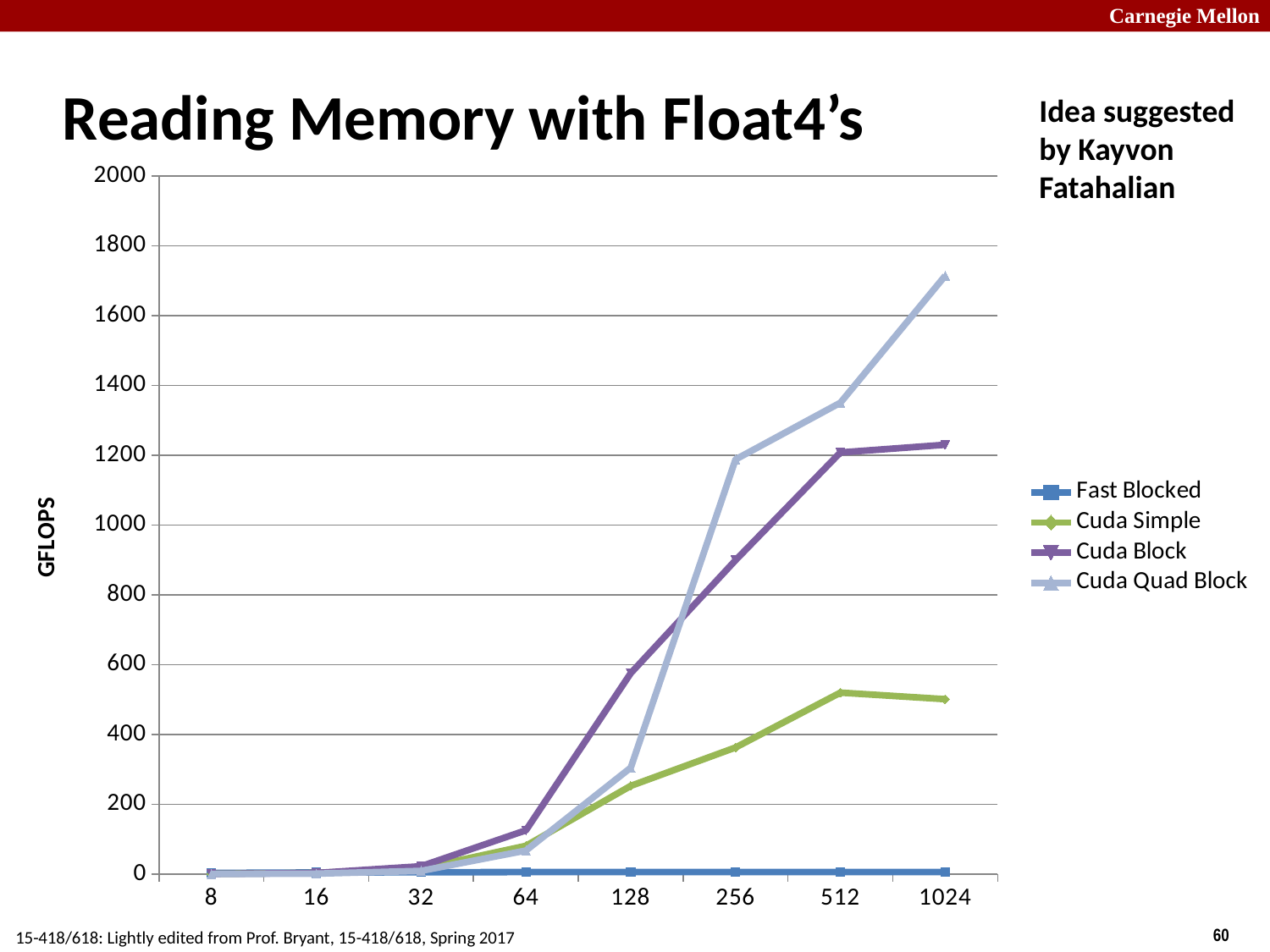
How many series does the legend list? 4 At 256, which is larger: Cuda Quad Block or Cuda Block? Cuda Quad Block Is the value for Cuda Simple at 1024 greater or less than 600? less What is the label on the y axis? GFLOPS Does the Cuda Quad Block series rise or fall from 8 to 1024? rise Is the value for Cuda Block at 512 greater or less than 1000? greater How many points are on the x axis? 8 What kind of chart is shown on the slide? line chart Which series has the highest value at 128? Cuda Block Is the value for Cuda Quad Block at 1024 greater or less than 1600? greater Which series has the highest value at 1024? Cuda Quad Block Which series has the lowest value at 1024? Fast Blocked